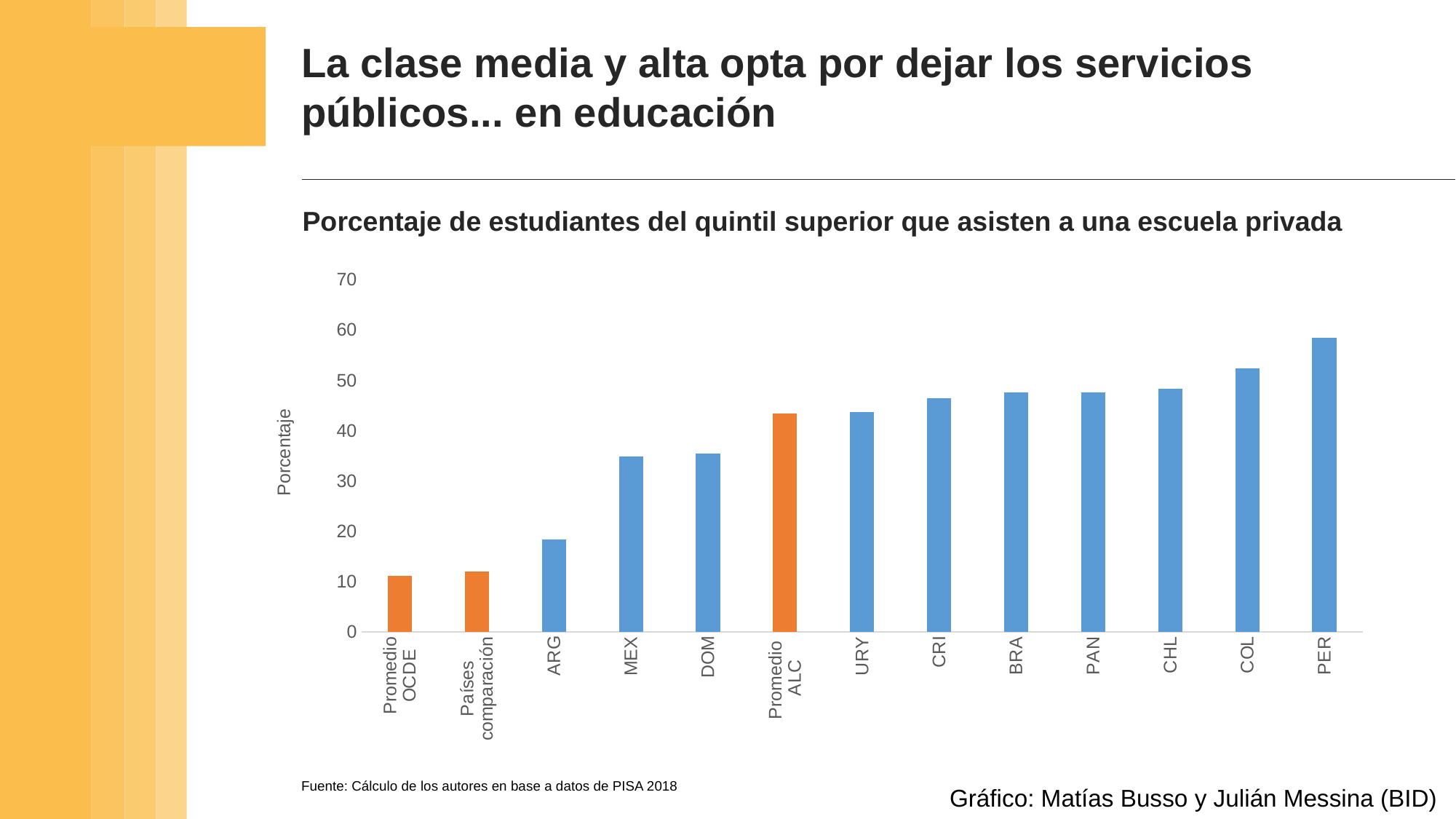
Is the value for ARG greater or less than 20? less How many categories are plotted on the x axis of the chart? 13 Is the value for Promedio OCDE greater or less than 20? less Which category has the highest value in the chart? PER Which has a larger value, ARG or MEX? MEX What kind of chart is shown on the slide? bar chart Is the value for MEX greater or less than 30? greater Which has a larger value, DOM or URY? URY Do the values rise or fall from left to right along the x axis? rise What is the label on the vertical axis of the chart? Porcentaje